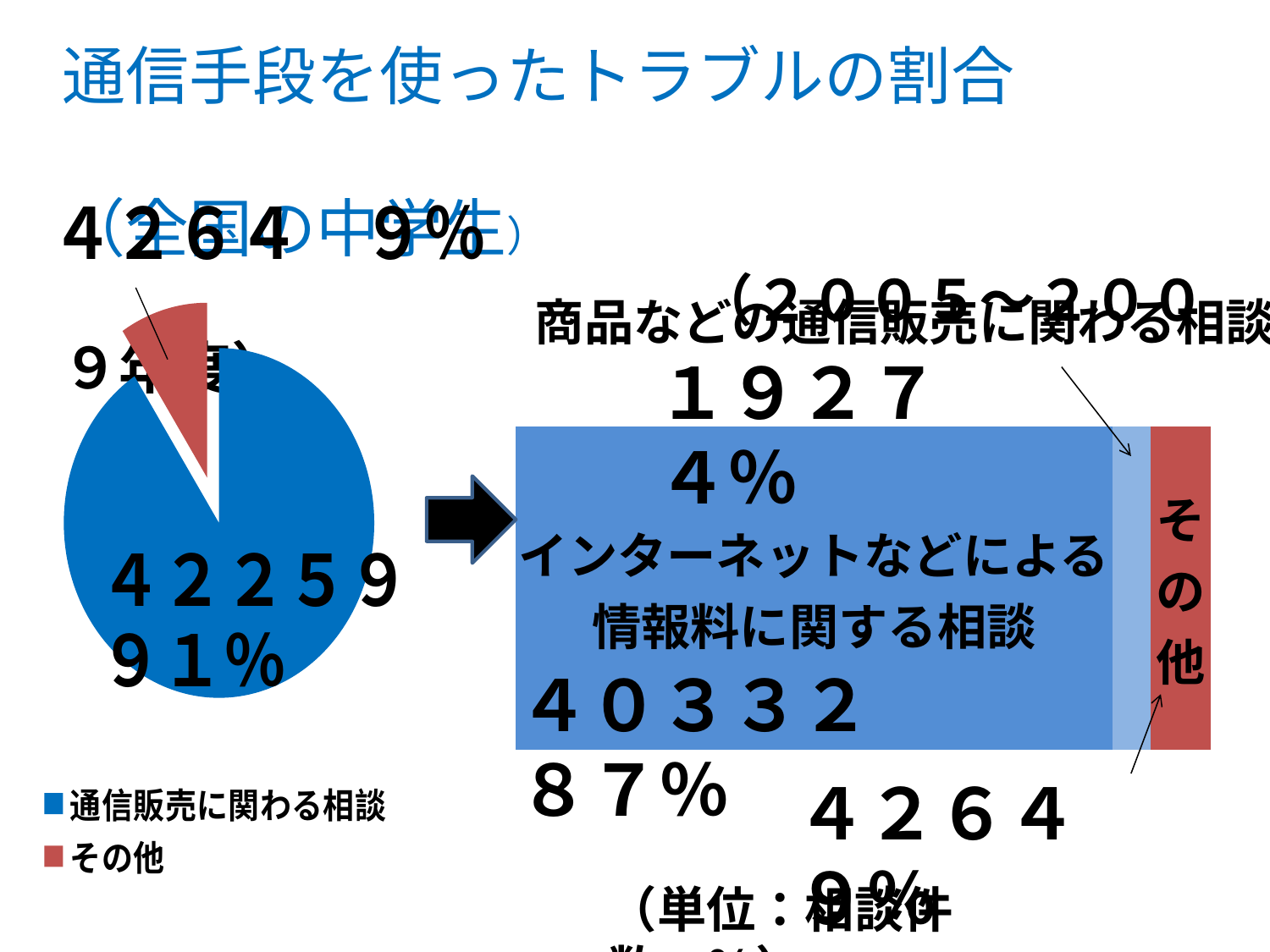
In the pie chart on the left, what value is shown for その他? 4264 How many entries does the legend of the pie chart on the left list? 2 What kind of chart is the chart on the right of the slide? bar chart In the bar chart on the right, which segment is the smallest? 商品などの通信販売に関わる相談 In the bar chart on the right, what percentage is shown for 商品などの通信販売に関わる相談? 4% What kind of chart is the chart on the left of the slide? pie chart In the pie chart on the left, what percentage is shown for その他? 9% In the pie chart on the left, what percentage is shown for 通信販売に関わる相談? 91% In the bar chart on the right, how many segments make up the stacked bar? 3 In the bar chart on the right, what value is shown for インターネットなどによる情報料に関する相談? 40332 In the bar chart on the right, what is the difference between the values for インターネットなどによる情報料に関する相談 and その他? 36068 In the pie chart on the left, which category has the largest slice? 通信販売に関わる相談